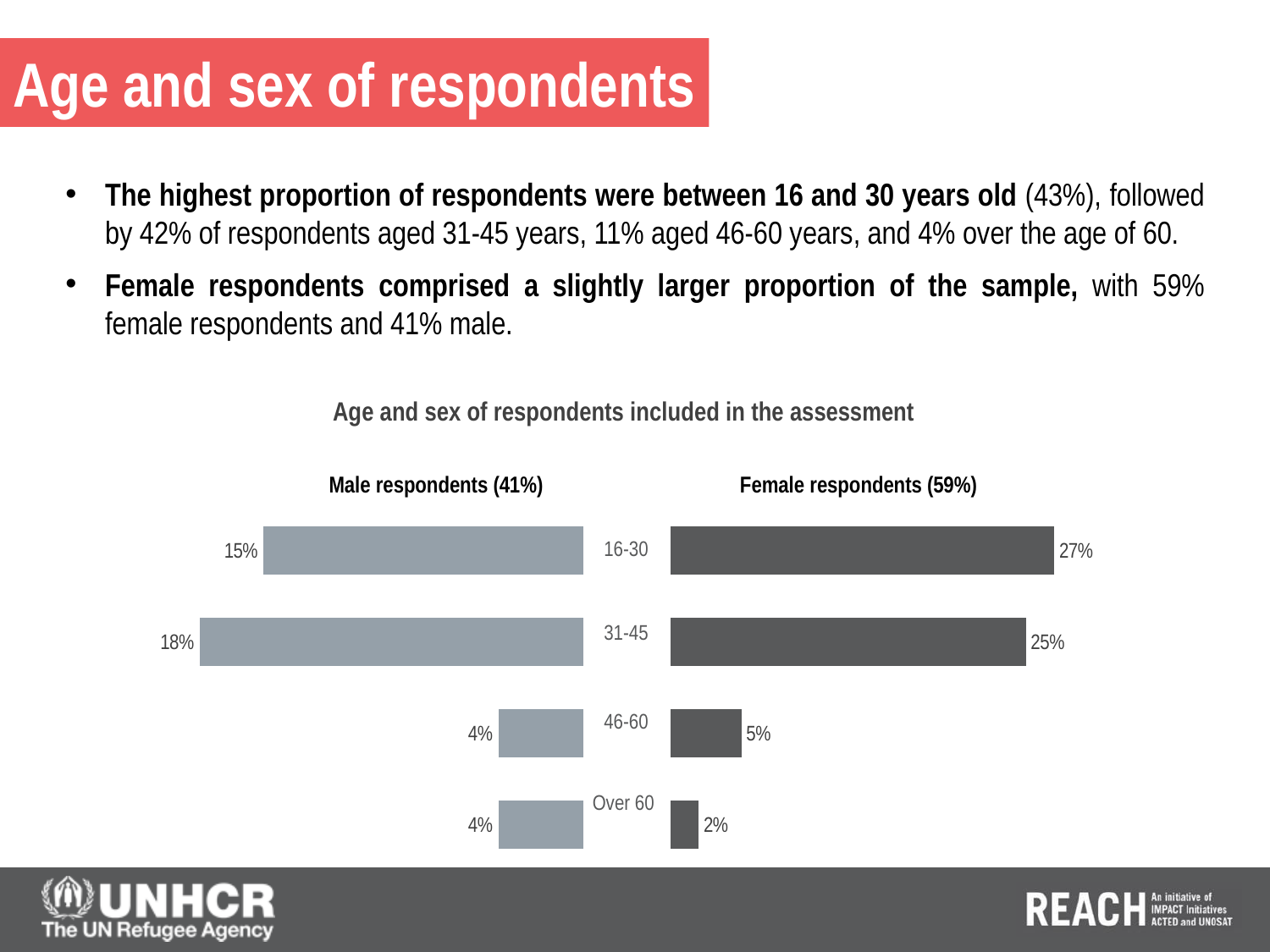
What is the value for the 16-30 age group among male respondents? 15% Which is larger for the 46-60 age group: the male value or the female value? Female What is the value for the 31-45 age group among female respondents? 25% What is the value for the Over 60 age group among female respondents? 2% What is the title of the chart? Age and sex of respondents included in the assessment What type of chart is shown on the slide? Bar chart What is the difference between the female and male values for the 16-30 age group? 12% What is the value for the 46-60 age group among male respondents? 4% Which age group has the lowest value among female respondents? Over 60 Which age group has the highest value among male respondents? 31-45 Which age group has the highest value among female respondents? 16-30 How many age groups are shown in the chart? 4